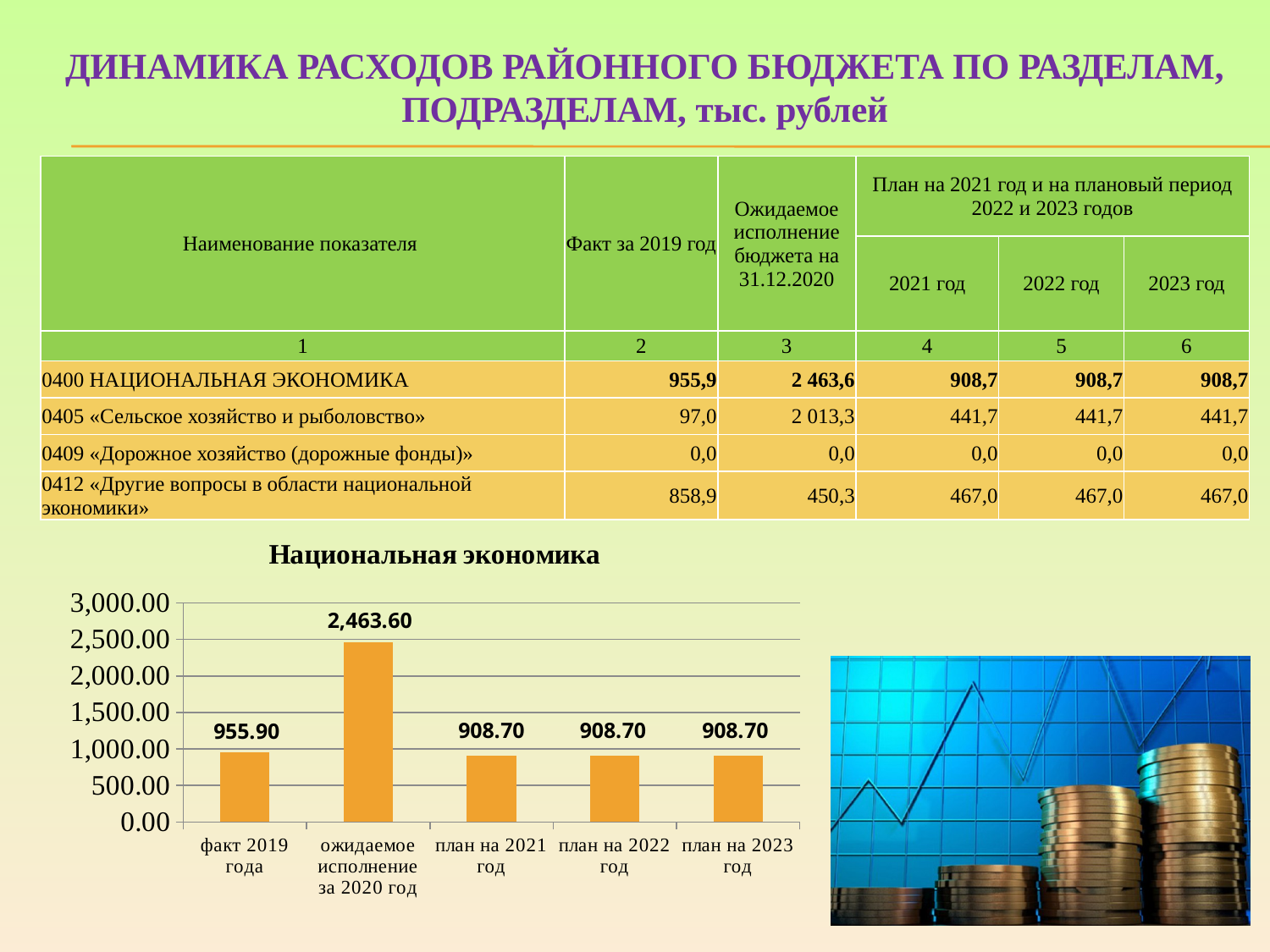
What is the value for "факт 2019 года" in the "Национальная экономика" chart? 955.90 What is the difference between the values for "факт 2019 года" and "план на 2021 год" in the "Национальная экономика" chart? 47.20 What is the difference between the values for "ожидаемое исполнение за 2020 год" and "факт 2019 года" in the "Национальная экономика" chart? 1,507.70 Is the value for "план на 2021 год" in the "Национальная экономика" chart greater or less than 1,000.00? less What is the value for "план на 2023 год" in the "Национальная экономика" chart? 908.70 In the "Национальная экономика" chart, which is larger: the value for "факт 2019 года" or the value for "план на 2022 год"? факт 2019 года What is the title of the chart on the slide? Национальная экономика What type of chart is the "Национальная экономика" chart? bar chart Which category has the highest value in the "Национальная экономика" chart? ожидаемое исполнение за 2020 год How many bars are shown in the "Национальная экономика" chart? 5 What is the value for "ожидаемое исполнение за 2020 год" in the "Национальная экономика" chart? 2,463.60 Is the value for "ожидаемое исполнение за 2020 год" in the "Национальная экономика" chart greater or less than 2,000.00? greater